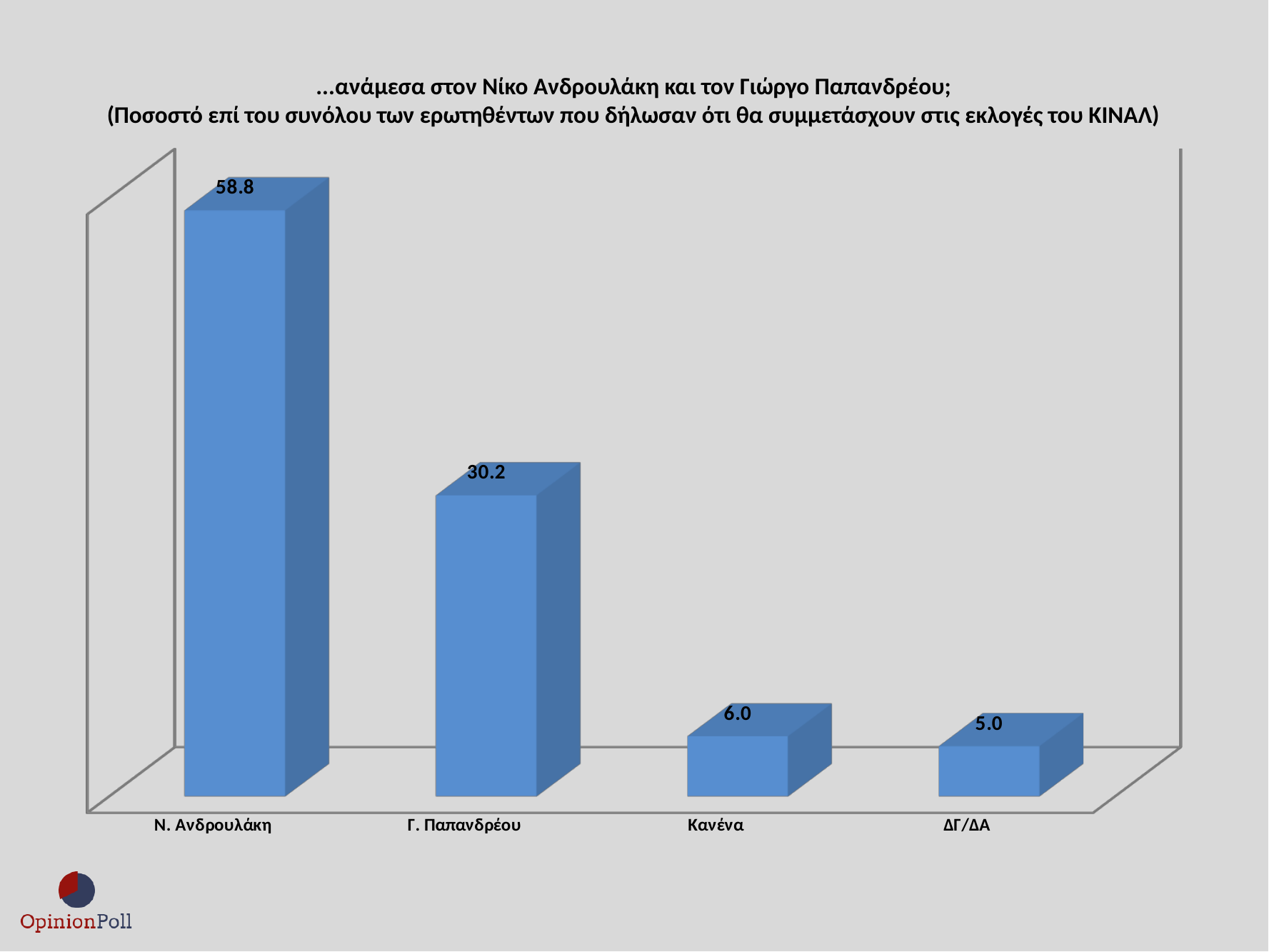
Do the values rise or fall from left to right along the x axis? fall What is the value for ΔΓ/ΔΑ? 5.0 Which is larger, the value for Γ. Παπανδρέου or the value for Κανένα? Γ. Παπανδρέου What is the value for Γ. Παπανδρέου? 30.2 How many categories are shown on the x axis? 4 What is the difference between the values for Ν. Ανδρουλάκη and Γ. Παπανδρέου? 28.6 What is the difference between the values for Κανένα and ΔΓ/ΔΑ? 1.0 Which category has the highest value? Ν. Ανδρουλάκη What is the value for Ν. Ανδρουλάκη? 58.8 Which category has the lowest value? ΔΓ/ΔΑ What is the value for Κανένα? 6.0 What kind of chart is this? bar chart